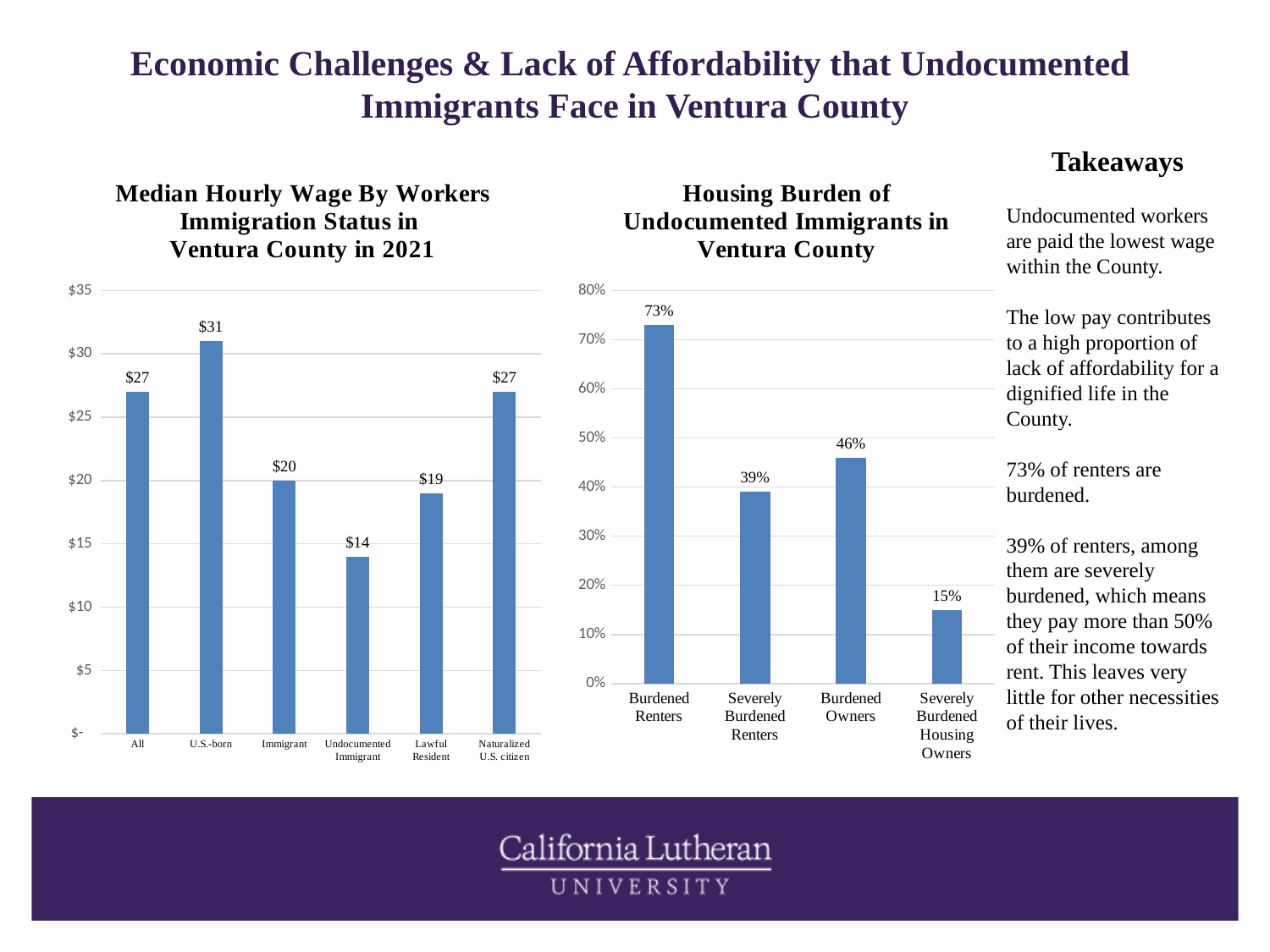
In the 'Housing Burden of Undocumented Immigrants in Ventura County' chart, what percentage of renters are burdened? 73% In the 'Housing Burden of Undocumented Immigrants in Ventura County' chart, what is the difference between Burdened Renters and Burdened Owners? 27% In the 'Housing Burden of Undocumented Immigrants in Ventura County' chart, which is larger: Severely Burdened Renters or Burdened Owners? Burdened Owners In the 'Housing Burden of Undocumented Immigrants in Ventura County' chart, which category has the lowest value? Severely Burdened Housing Owners In the 'Median Hourly Wage By Workers Immigration Status in Ventura County in 2021' chart, which category has the lowest median hourly wage? Undocumented Immigrant In the 'Median Hourly Wage By Workers Immigration Status in Ventura County in 2021' chart, which is larger: the wage for Immigrant or for Lawful Resident? Immigrant How many categories are shown in the 'Median Hourly Wage By Workers Immigration Status in Ventura County in 2021' chart? 6 In the 'Median Hourly Wage By Workers Immigration Status in Ventura County in 2021' chart, what is the median hourly wage for Undocumented Immigrant workers? $14 In the 'Median Hourly Wage By Workers Immigration Status in Ventura County in 2021' chart, what is the difference between the U.S.-born wage and the Undocumented Immigrant wage? $17 In the 'Median Hourly Wage By Workers Immigration Status in Ventura County in 2021' chart, what is the median hourly wage for Naturalized U.S. citizen workers? $27 What type of chart is the 'Housing Burden of Undocumented Immigrants in Ventura County' chart? Bar chart In the 'Median Hourly Wage By Workers Immigration Status in Ventura County in 2021' chart, which category has the highest median hourly wage? U.S.-born